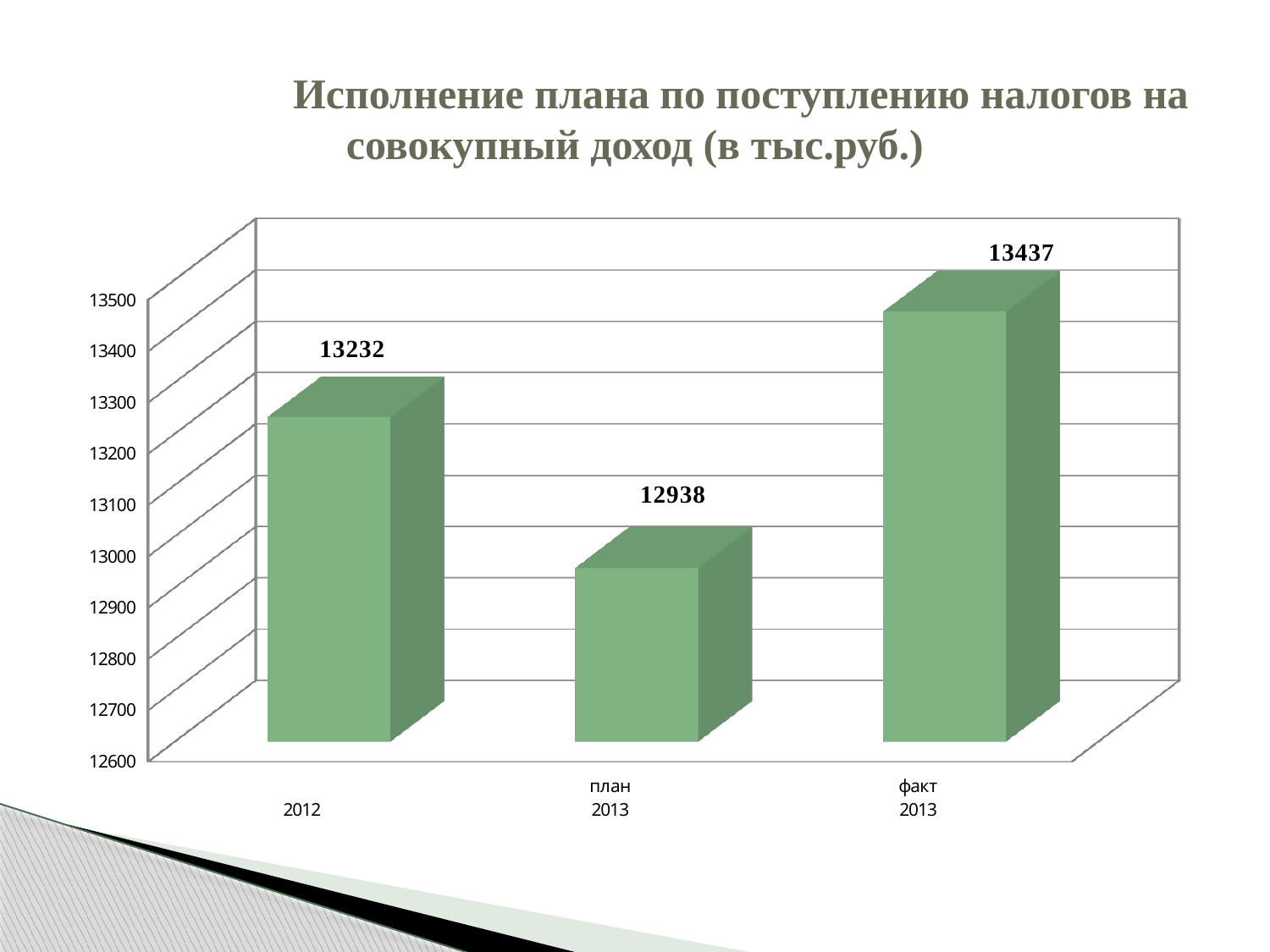
How many bars are shown in the chart? 3 What is the difference between факт 2013 and 2012? 205 What is the title of the chart? Исполнение плана по поступлению налогов на совокупный доход (в тыс.руб.) What is the value for факт 2013? 13437 Is the value for план 2013 greater or less than 13000? less Which category has the highest value? факт 2013 What is the value for план 2013? 12938 What kind of chart is shown on the slide? bar chart Which is larger, the value for 2012 or the value for план 2013? 2012 What is the value for 2012? 13232 What is the difference between факт 2013 and план 2013? 499 Which category has the lowest value? план 2013